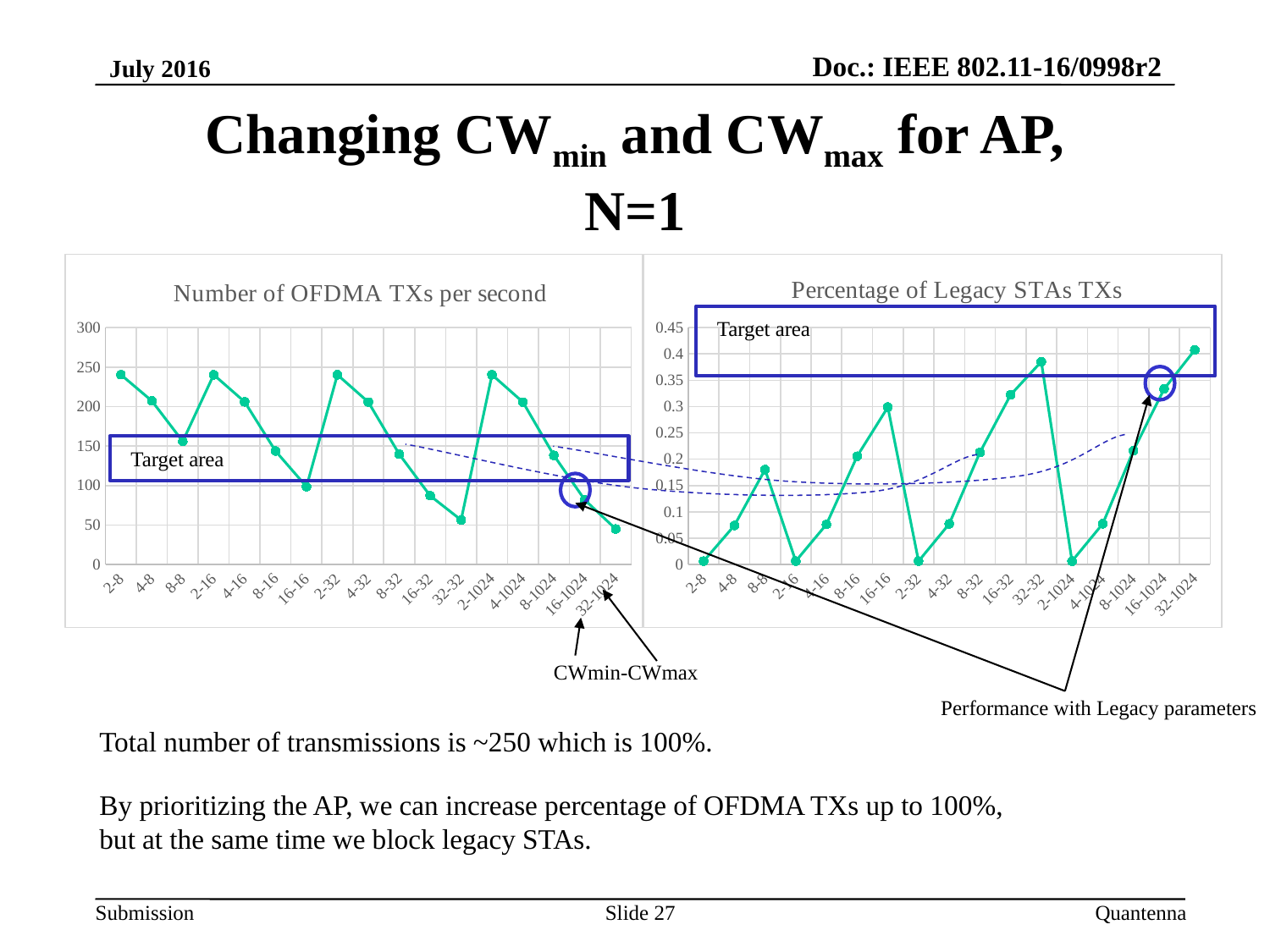
In the 'Number of OFDMA TXs per second' chart, is the value for 32-32 greater or less than 100? less In the 'Percentage of Legacy STAs TXs' chart, which category has the highest value? 32-1024 In the 'Percentage of Legacy STAs TXs' chart, which is larger, the value for 32-32 or the value for 16-32? 32-32 In the 'Number of OFDMA TXs per second' chart, is the value for 2-8 greater or less than 200? greater In the 'Number of OFDMA TXs per second' chart, which is larger, the value for 8-8 or the value for 16-16? 8-8 How many CWmin-CWmax categories are plotted along the x axis of the 'Number of OFDMA TXs per second' chart? 17 In the 'Percentage of Legacy STAs TXs' chart, is the value for 4-8 greater or less than 0.1? less What label is given to the x axis categories of the charts, as annotated below the left chart? CWmin-CWmax What is the title of the chart on the right side of the slide? Percentage of Legacy STAs TXs In the 'Number of OFDMA TXs per second' chart, which category has the lowest value? 32-1024 What kind of chart is the 'Number of OFDMA TXs per second' chart on the left? line chart